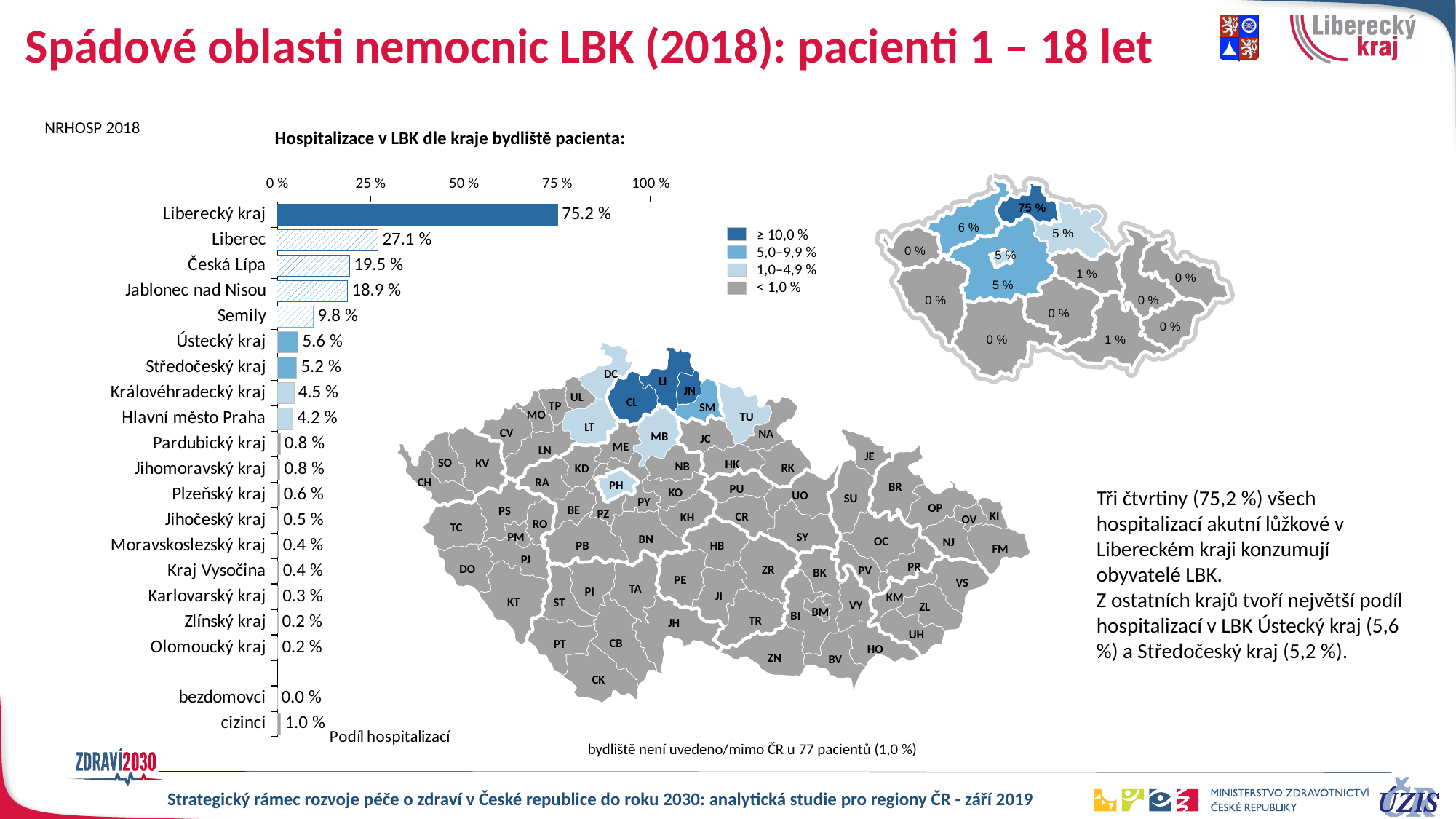
In the bar chart, what is the value for cizinci? 1.0 % In the bar chart, what is the difference between the values for Liberec and Česká Lípa? 7.6 % In the bar chart, which is larger: the value for Ústecký kraj or Středočeský kraj? Ústecký kraj In the bar chart, which category has the highest value? Liberecký kraj In the bar chart, which category has the lowest value? bezdomovci What is the title of the bar chart on the left of the slide? Hospitalizace v LBK dle kraje bydliště pacienta: In the bar chart, is the value for Liberecký kraj greater or less than 50 %? greater In the bar chart, what is the value for Ústecký kraj? 5.6 % How many categories are shown in the bar chart? 20 What kind of chart is 'Hospitalizace v LBK dle kraje bydliště pacienta'? bar chart In the bar chart 'Hospitalizace v LBK dle kraje bydliště pacienta', what is the value for Liberecký kraj? 75.2 % In the bar chart, what is the value for Semily? 9.8 %